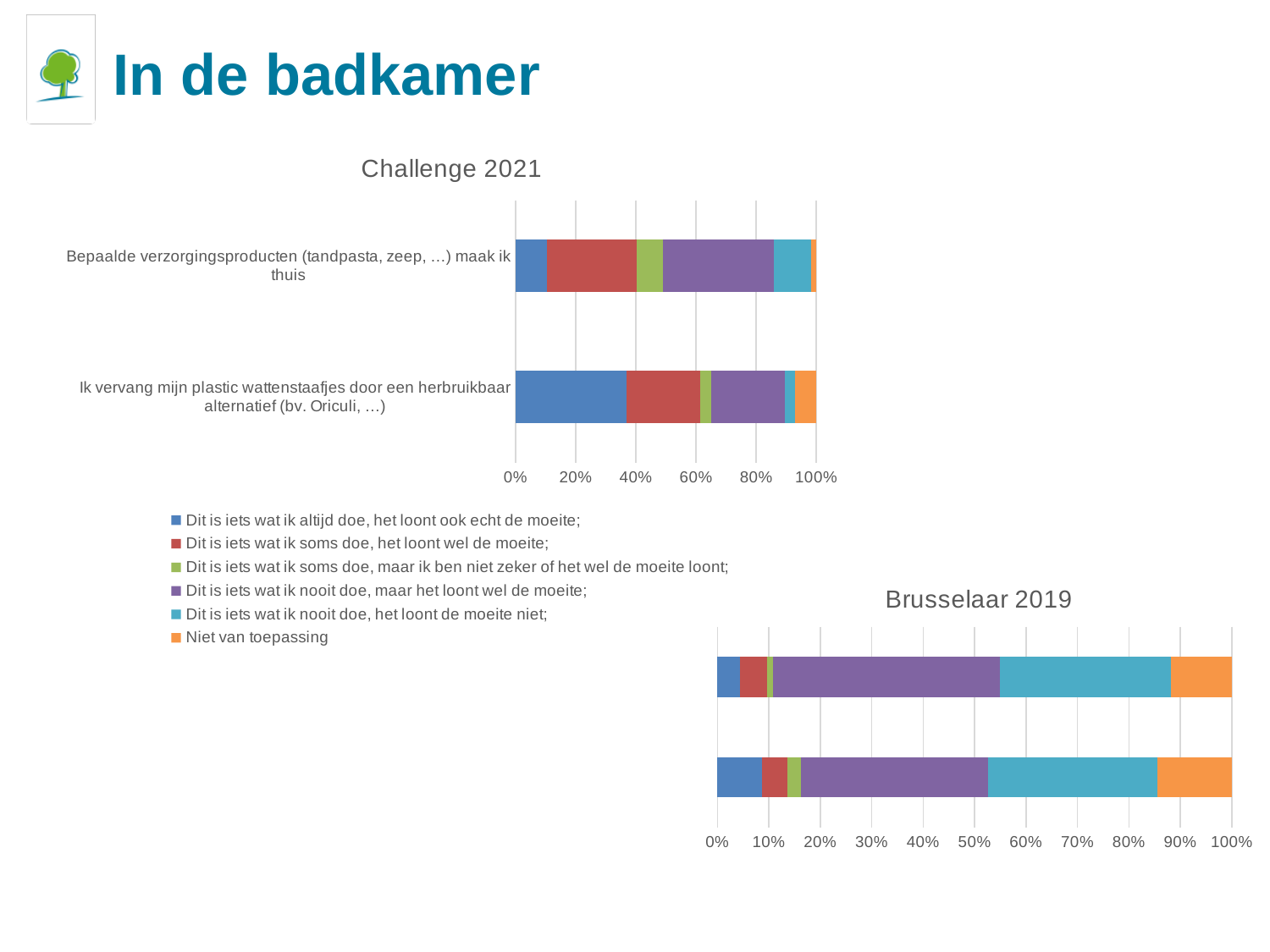
How many bars are shown in the "Brusselaar 2019" chart? 2 How many categories are shown in the "Challenge 2021" chart? 2 What is the highest value shown on the x axis of the "Brusselaar 2019" chart? 100% What is the title of the chart on the right side of the slide? Brusselaar 2019 Which legend entry is shown in orange? Niet van toepassing In the "Challenge 2021" chart, which category has the larger value for "Dit is iets wat ik altijd doe, het loont ook echt de moeite;"? Ik vervang mijn plastic wattenstaafjes door een herbruikbaar alternatief (bv. Oriculi, …) In the "Challenge 2021" chart, is the value of "Dit is iets wat ik altijd doe, het loont ook echt de moeite;" for "Ik vervang mijn plastic wattenstaafjes door een herbruikbaar alternatief (bv. Oriculi, …)" greater or less than 20%? greater How many series does the legend list for the "Challenge 2021" chart? 6 What kind of chart is the "Challenge 2021" chart? Stacked bar chart In the "Challenge 2021" chart, is the value of "Dit is iets wat ik soms doe, het loont wel de moeite;" for "Bepaalde verzorgingsproducten (tandpasta, zeep, …) maak ik thuis" greater or less than 20%? greater In the "Challenge 2021" chart, is the value of "Dit is iets wat ik altijd doe, het loont ook echt de moeite;" for "Bepaalde verzorgingsproducten (tandpasta, zeep, …) maak ik thuis" greater or less than 20%? less